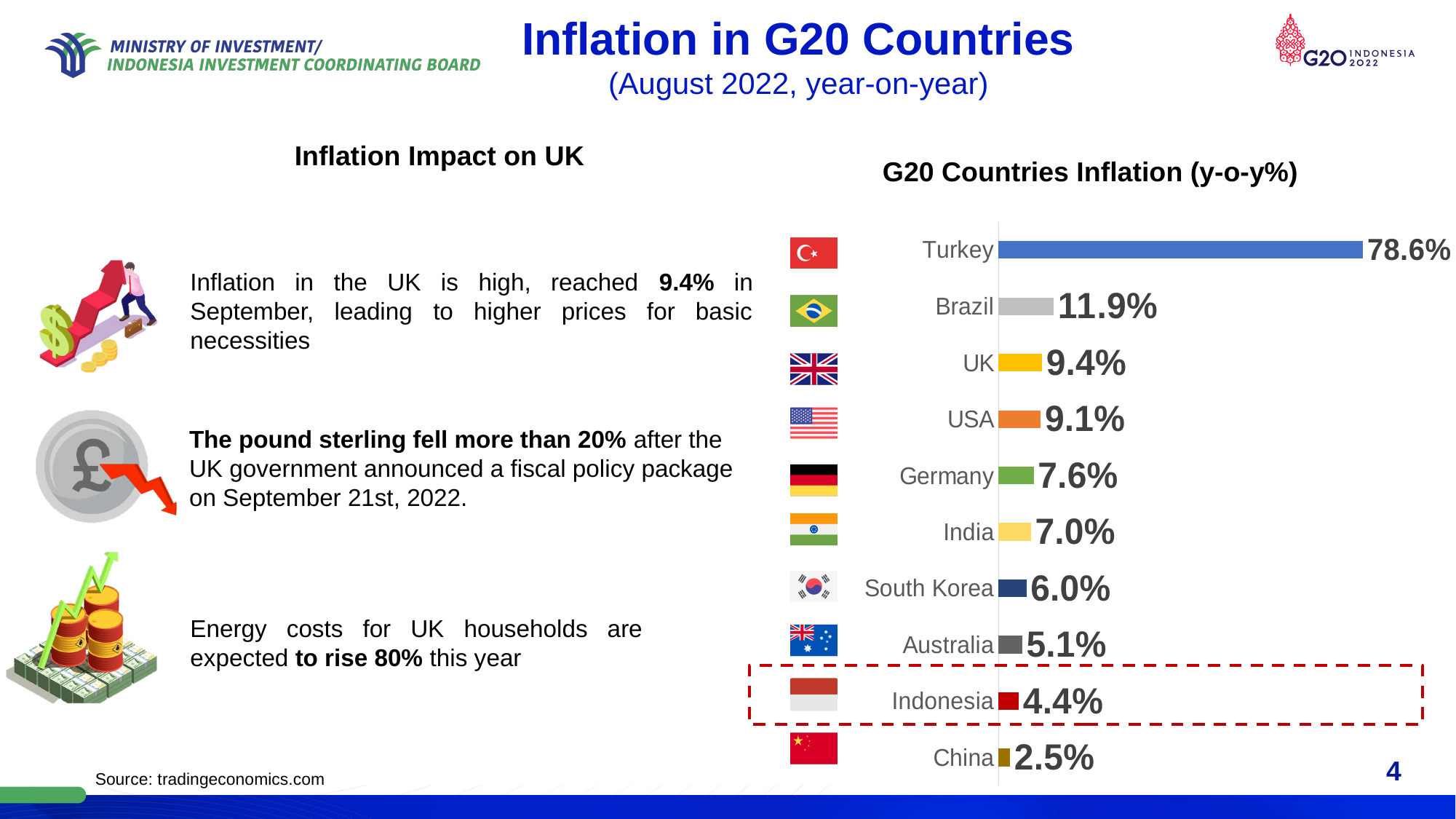
How many countries are shown in the chart? 10 Which country has the lowest inflation rate in the chart? China What is the inflation rate shown for Germany? 7.6% Which has a higher inflation rate, South Korea or India? India What is the difference between the inflation rates of Brazil and the UK? 2.5% What is the inflation rate shown for Turkey? 78.6% Which has a higher inflation rate, the USA or Germany? USA What is the difference between the inflation rates of Australia and Indonesia? 0.7% What is the title of the chart? G20 Countries Inflation (y-o-y%) What is the inflation rate shown for Indonesia? 4.4% Which country has the highest inflation rate in the chart? Turkey What type of chart is used to show G20 countries' inflation? Bar chart